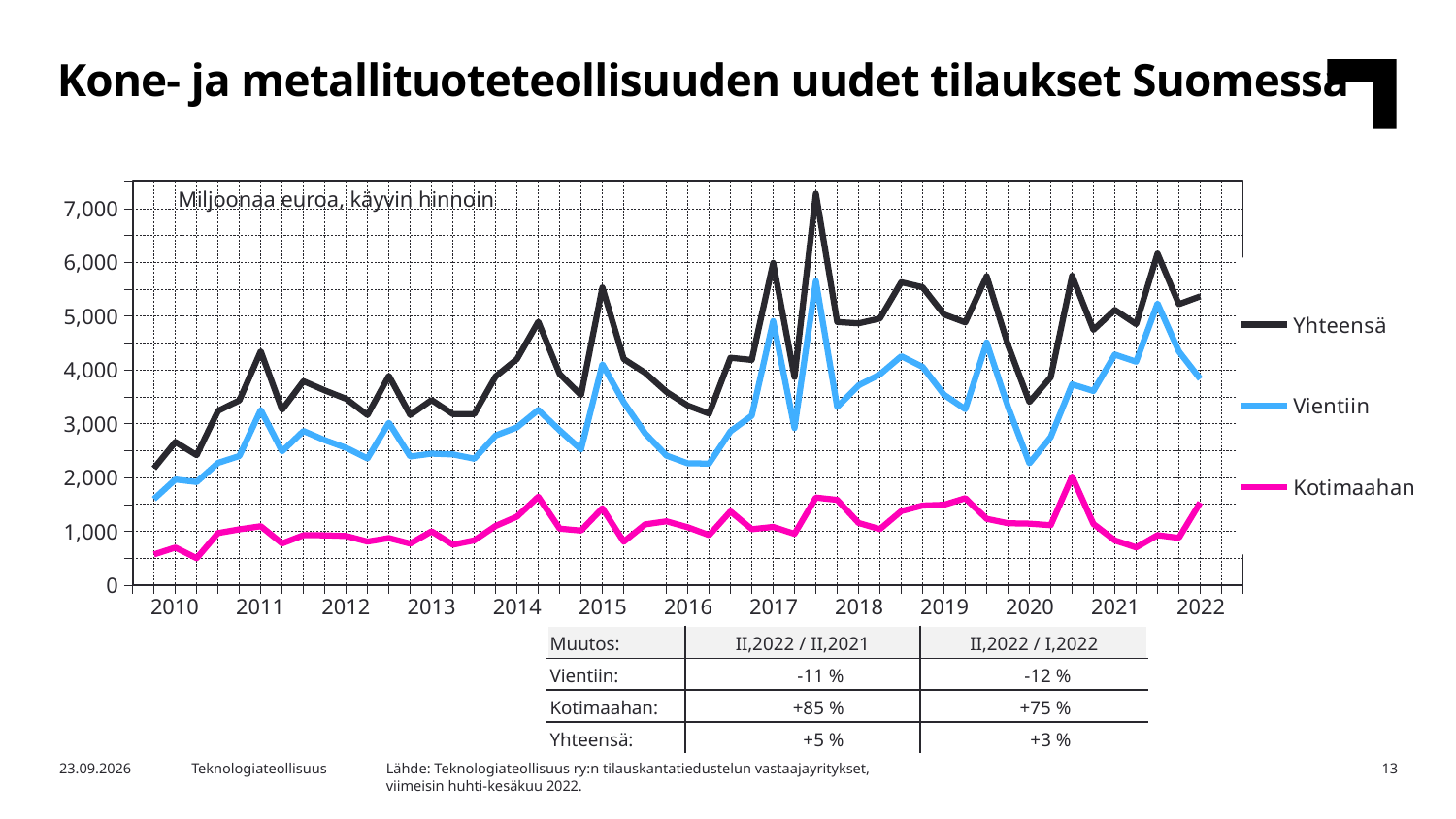
Which series is larger at the start of 2010, Vientiin or Kotimaahan? Vientiin In which year does the Yhteensä series reach its highest peak? 2017 Which series is plotted with the black line? Yhteensä What is the title of the slide's chart? Kone- ja metallituoteteollisuuden uudet tilaukset Suomessa How many series does the legend list? 3 Does the Yhteensä series generally rise or fall from 2010 to 2022? rise Is the highest peak of the Yhteensä series greater or less than 7,000? greater What unit is stated inside the chart area? Miljoonaa euroa, käyvin hinnoin Is the highest peak of the Vientiin series greater or less than 5,000? greater What kind of chart is shown on the slide? line chart Is the first value of the Kotimaahan series in 2010 greater or less than 1,000? less Which series has the lowest values throughout the chart? Kotimaahan